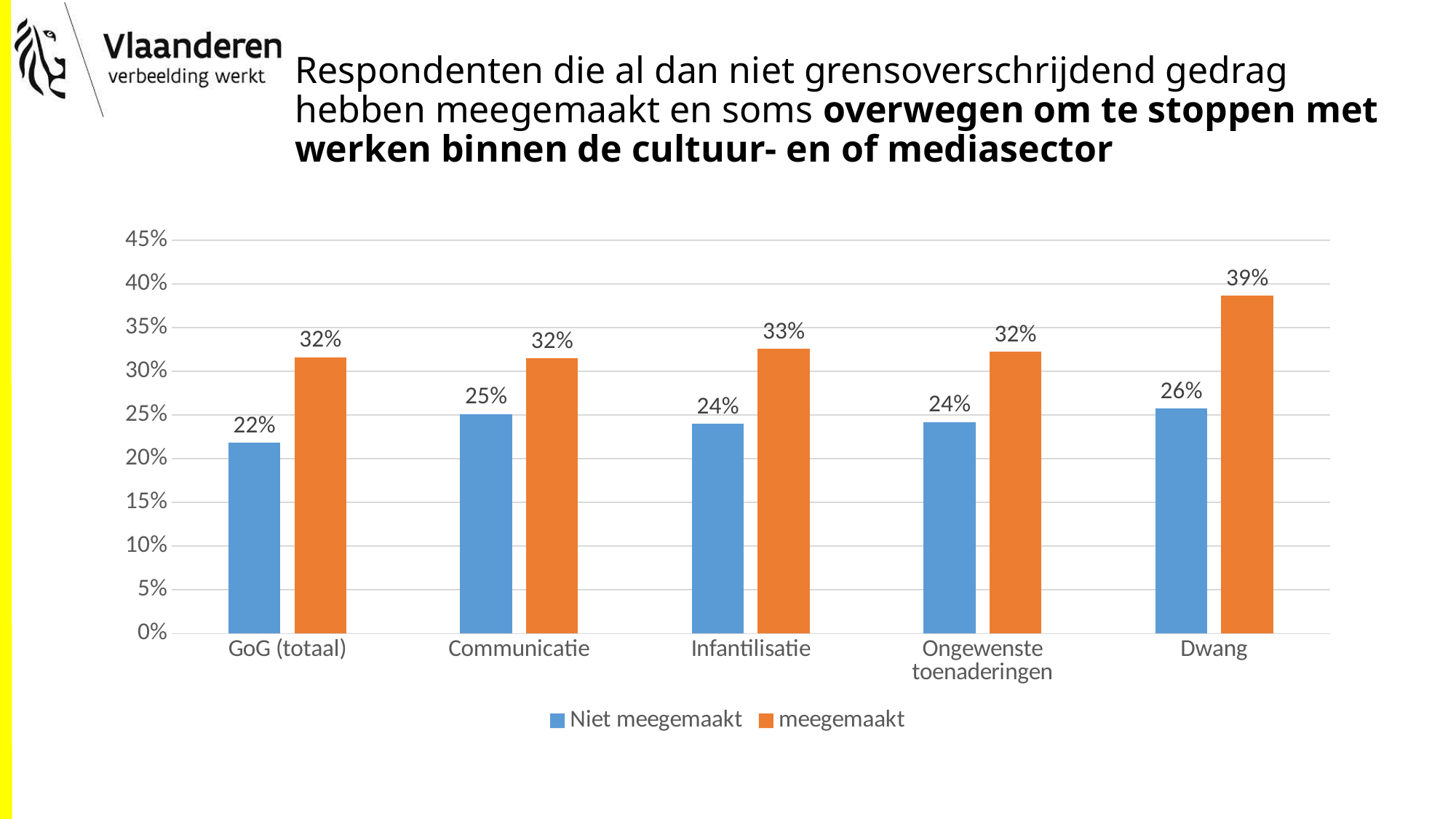
Is the "meegemaakt" value for Dwang greater or less than 35%? greater How many series does the legend list? 2 What is the difference between the "meegemaakt" and "Niet meegemaakt" values for Dwang? 13% Which category has the highest value for the "meegemaakt" series? Dwang How many categories are shown on the x axis? 5 What is the value for "meegemaakt" in the Infantilisatie category? 33% Which is larger for Communicatie: the "Niet meegemaakt" value or the "meegemaakt" value? meegemaakt What kind of chart is shown on the slide? bar chart Which category has the lowest value for the "Niet meegemaakt" series? GoG (totaal) Which colour represents the "Niet meegemaakt" series? blue What is the value for "Niet meegemaakt" in the GoG (totaal) category? 22% What is the value for "meegemaakt" in the Dwang category? 39%